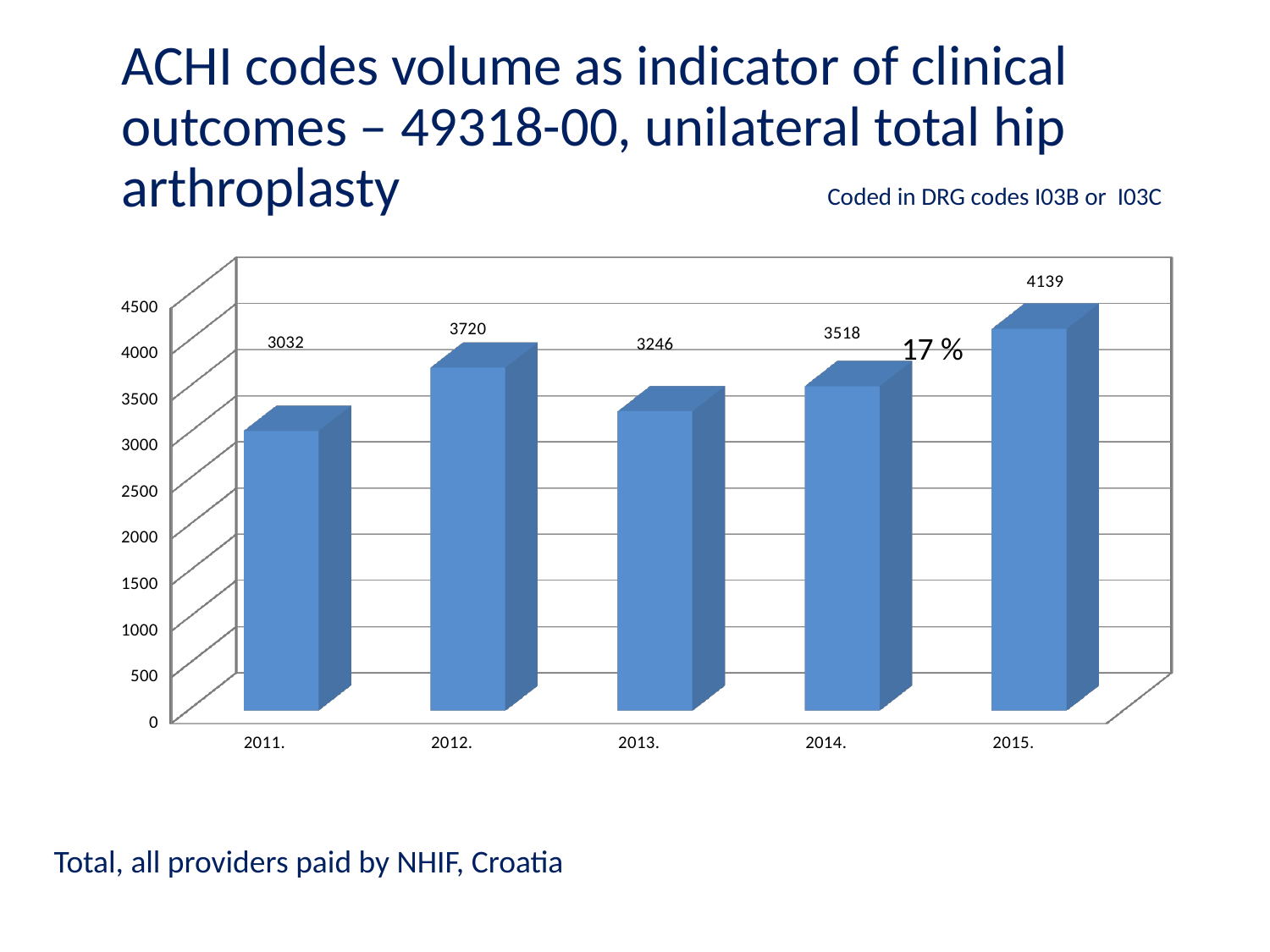
What is the value for 2015.? 4139 Which year has the lowest value? 2011. Which is larger, the value for 2012. or the value for 2013.? 2012. How many years are shown on the x axis? 5 What kind of chart is shown on the slide? bar chart What is the difference between the values for 2015. and 2014.? 621 Which year has the highest value? 2015. Is the value for 2014. greater or less than 3000? greater What percentage annotation is printed near the 2014. bar? 17 % What is the difference between the values for 2012. and 2011.? 688 What is the value for 2013.? 3246 What is the value for 2011.? 3032